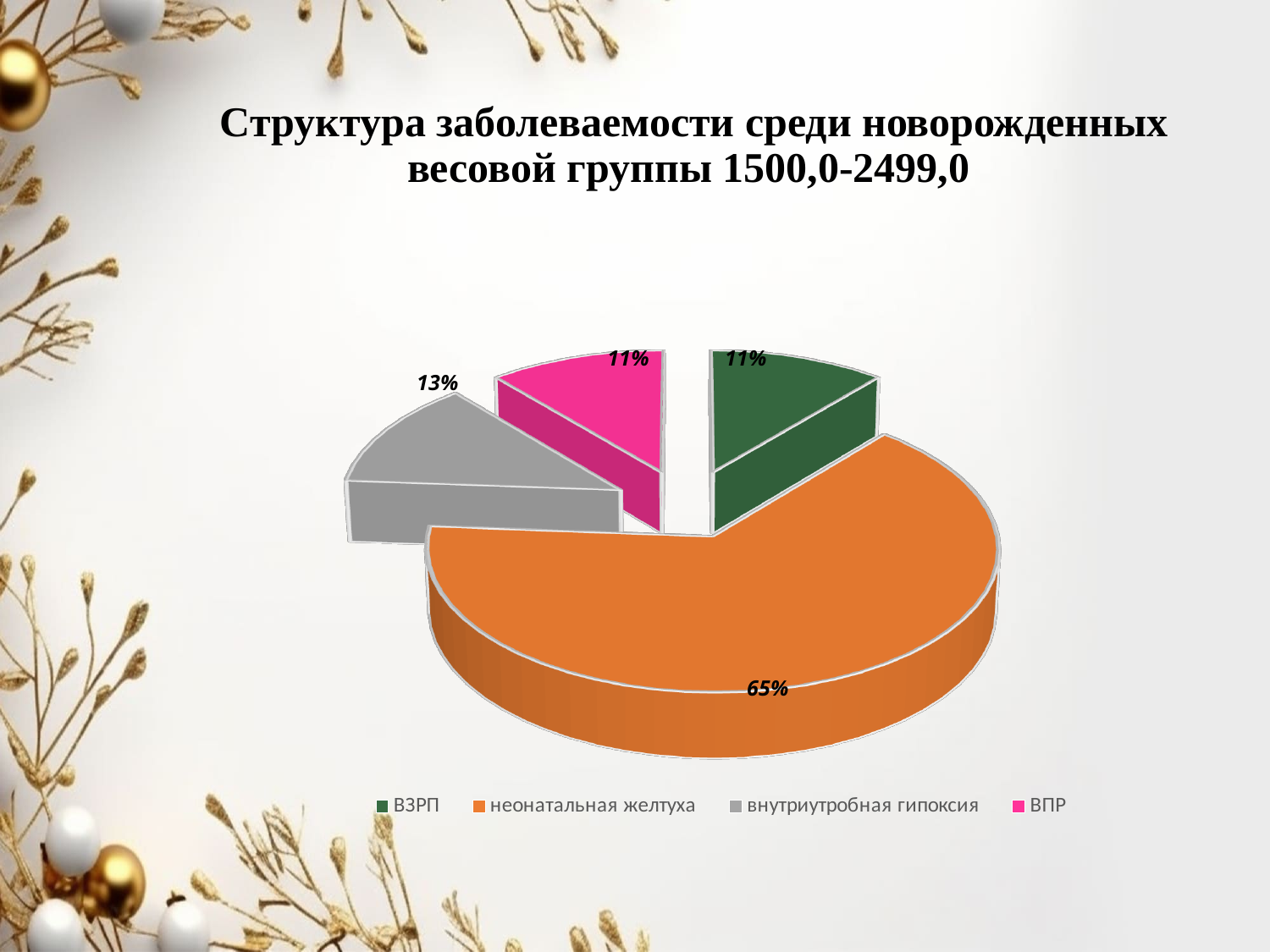
What is the difference between the shares of неонатальная желтуха and внутриутробная гипоксия? 52% What share of the pie does неонатальная желтуха account for? 65% How many entries does the legend list? 4 What colour is the slice for неонатальная желтуха? orange What is the value shown for ВПР? 11% What share of the pie does внутриутробная гипоксия account for? 13% How many categories does the pie chart show? 4 What kind of chart is shown on the slide? pie chart Which category has the largest slice of the pie? неонатальная желтуха What is the value shown for ВЗРП? 11% What is the title of the chart? Структура заболеваемости среди новорожденных весовой группы 1500,0-2499,0 Which is larger, the share of внутриутробная гипоксия or the share of ВПР? внутриутробная гипоксия